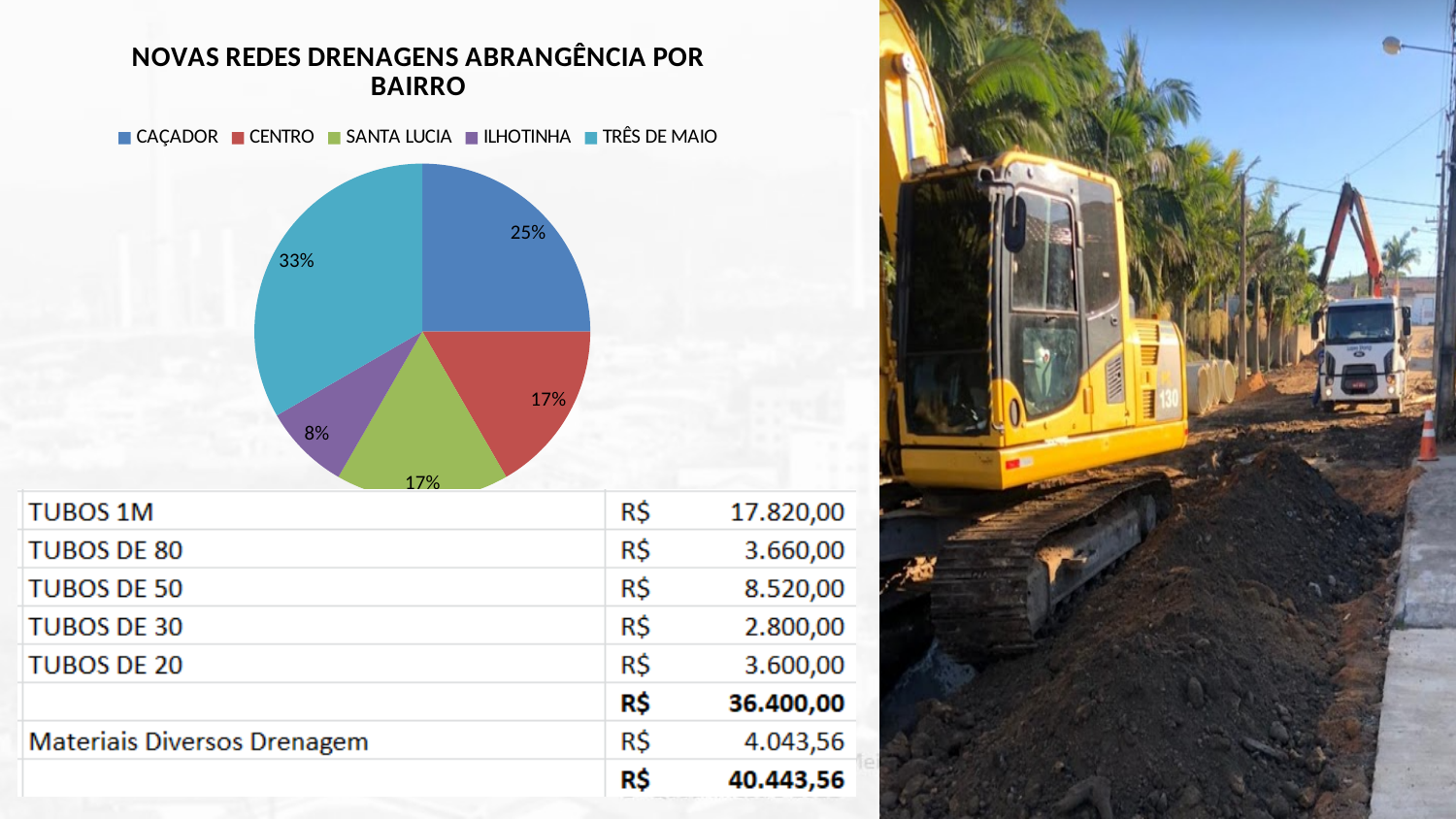
What share of the pie does ILHOTINHA have? 8% Which neighbourhood has the smallest slice of the pie? ILHOTINHA What share of the pie does CENTRO have? 17% What kind of chart is shown on the slide? pie chart Which colour represents SANTA LUCIA in the pie chart? green How many categories does the legend of the pie chart list? 5 What share of the pie does CAÇADOR have? 25% What is the title of the pie chart? NOVAS REDES DRENAGENS ABRANGÊNCIA POR BAIRRO Which neighbourhood has the largest slice of the pie? TRÊS DE MAIO Which slice is larger, CAÇADOR or ILHOTINHA? CAÇADOR What is the difference in percentage points between the TRÊS DE MAIO slice and the CAÇADOR slice? 8